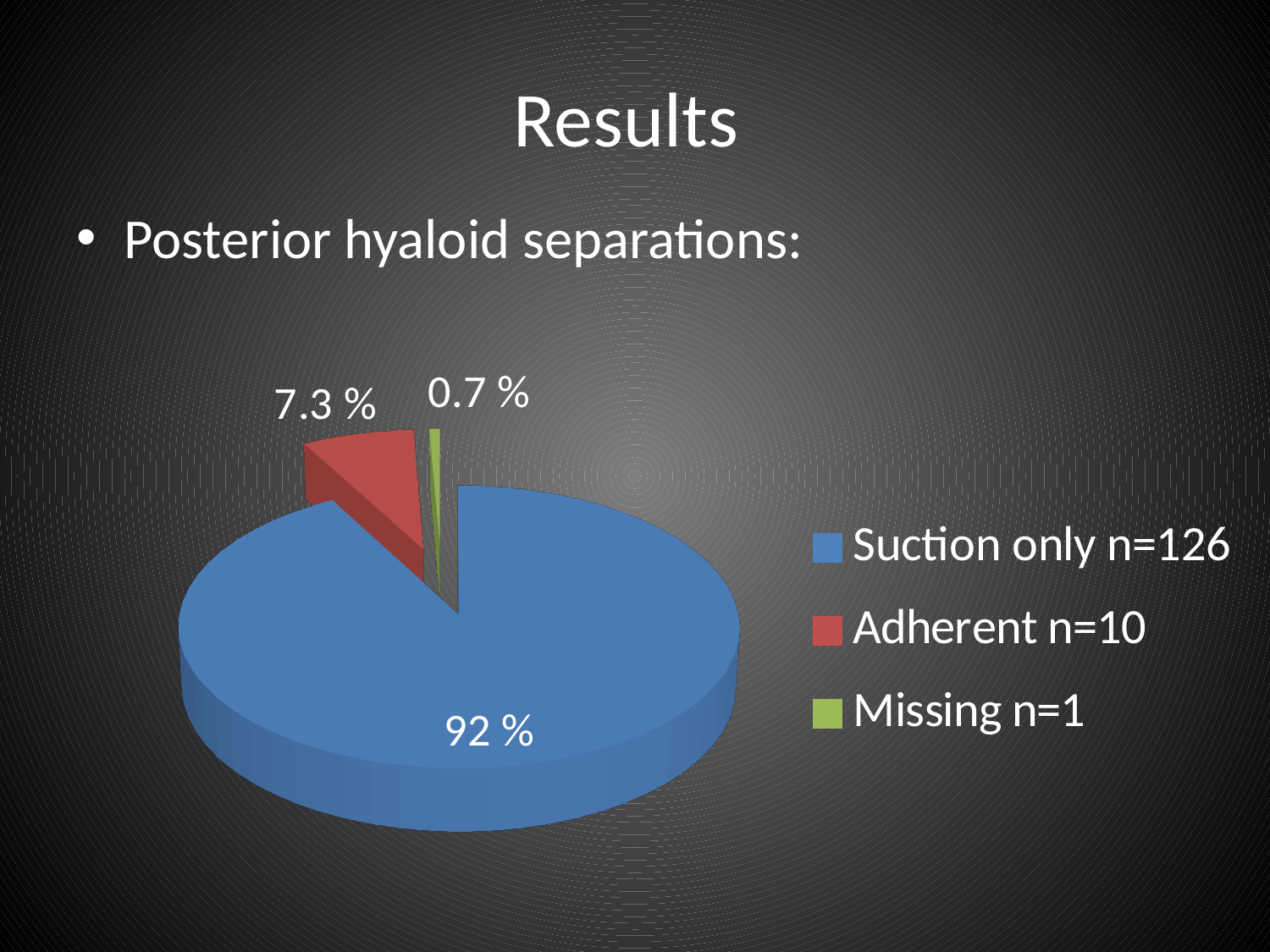
Which slice is larger, Adherent or Missing? Adherent What percentage is shown for the Suction only slice? 92 % What percentage is shown for the Adherent slice? 7.3 % Which category has the smallest slice of the pie? Missing n=1 What is the bullet text above the chart? Posterior hyaloid separations: What is the n value given in the legend for Suction only? 126 What kind of chart is shown on the slide? pie chart What is the difference in percentage points between the Adherent slice and the Missing slice? 6.6 Which category has the largest slice of the pie? Suction only n=126 What percentage is shown for the Missing slice? 0.7 % What colour is the Adherent slice? red How many categories does the pie chart show? 3